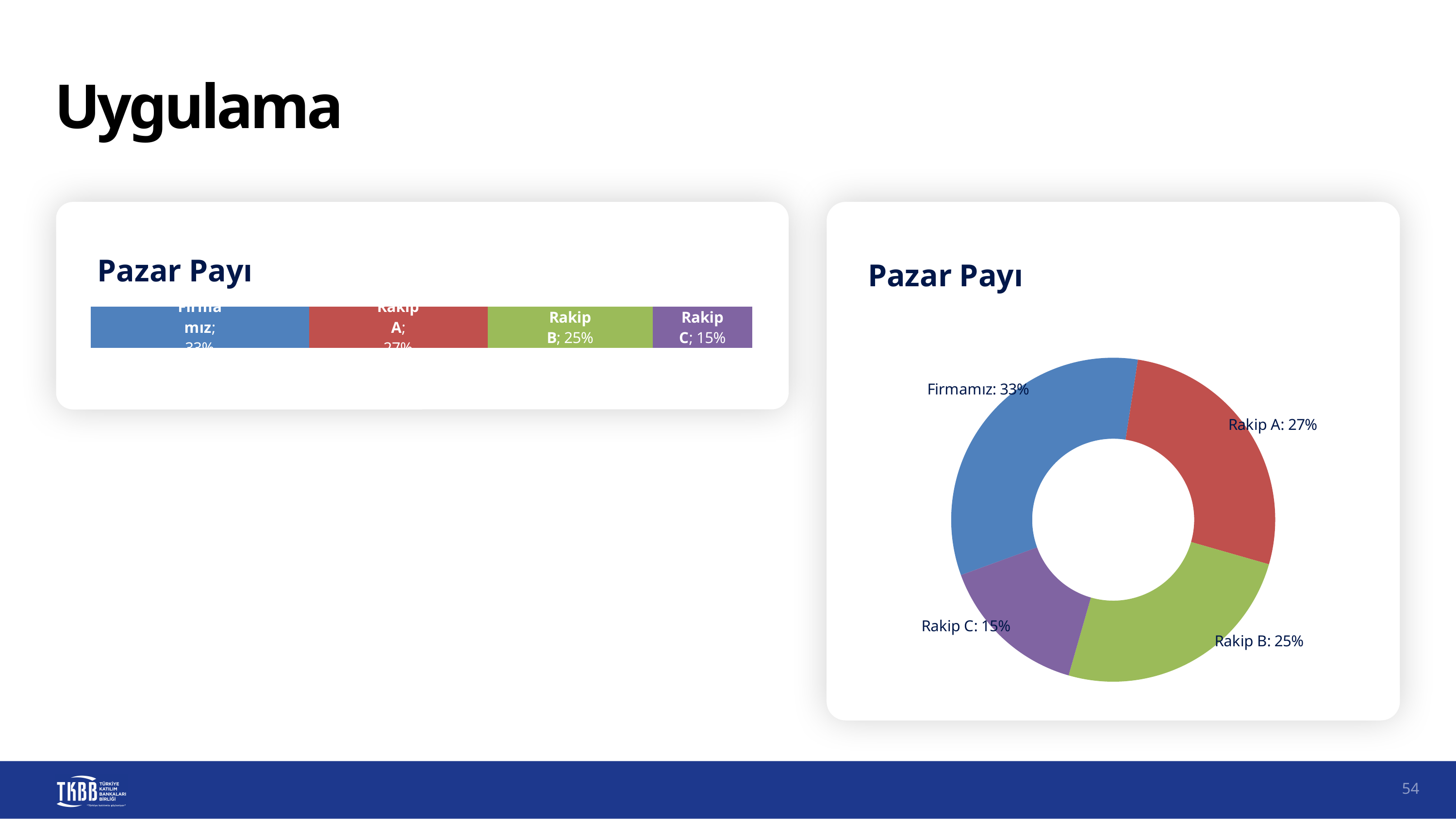
In the doughnut chart on the right, how many categories are shown? 4 In the stacked bar chart on the left, what is the value for Rakip C? 15% In the doughnut chart on the right, what is the share for Rakip A? 27% In the doughnut chart on the right, which category has the largest share? Firmamız In the stacked bar chart on the left, what is the value for Rakip B? 25% In the doughnut chart on the right, what is the share for Rakip C? 15% In the doughnut chart on the right, which category has the smallest share? Rakip C What kind of chart is the chart on the left of the slide? Stacked bar chart In the doughnut chart on the right, what is the difference between the shares of Firmamız and Rakip C? 18% What kind of chart is the chart on the right of the slide? Doughnut chart In the doughnut chart on the right, what is the share for Firmamız? 33% In the doughnut chart on the right, what is the share for Rakip B? 25%